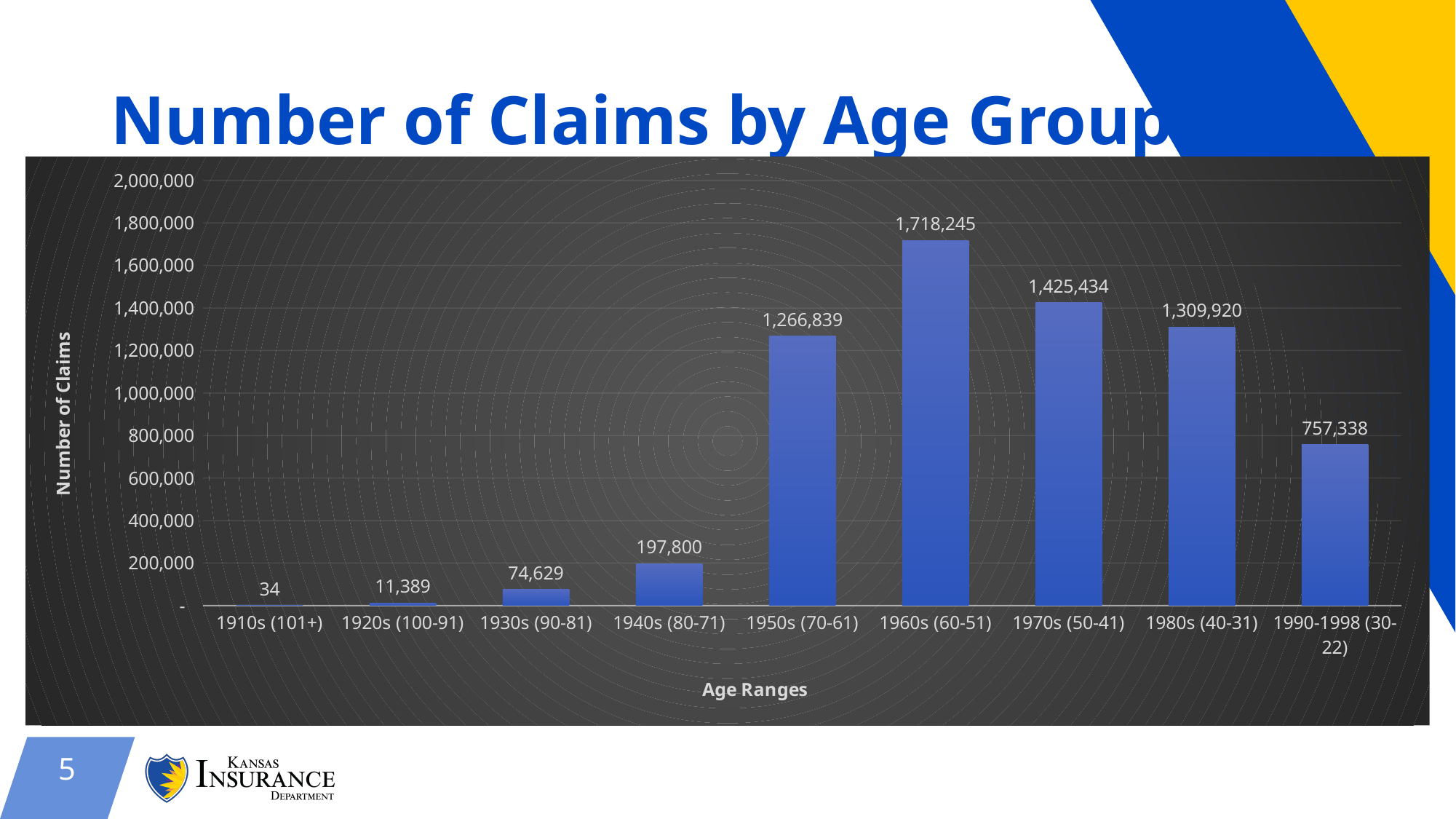
How many age groups are shown on the x axis? 9 What is the number of claims for the 1990-1998 (30-22) age group? 757,338 What is the difference in claims between the 1970s (50-41) and 1980s (40-31) age groups? 115,514 What is the label of the x axis? Age Ranges Which age group has more claims, 1950s (70-61) or 1980s (40-31)? 1980s (40-31) Is the value for the 1990-1998 (30-22) age group greater or less than 800,000? less What is the number of claims for the 1960s (60-51) age group? 1,718,245 Which age group has the highest number of claims? 1960s (60-51) What kind of chart is shown on the slide? bar chart Which age group has the lowest number of claims? 1910s (101+) What is the number of claims for the 1940s (80-71) age group? 197,800 Do the values rise or fall from the 1910s (101+) group to the 1960s (60-51) group? rise